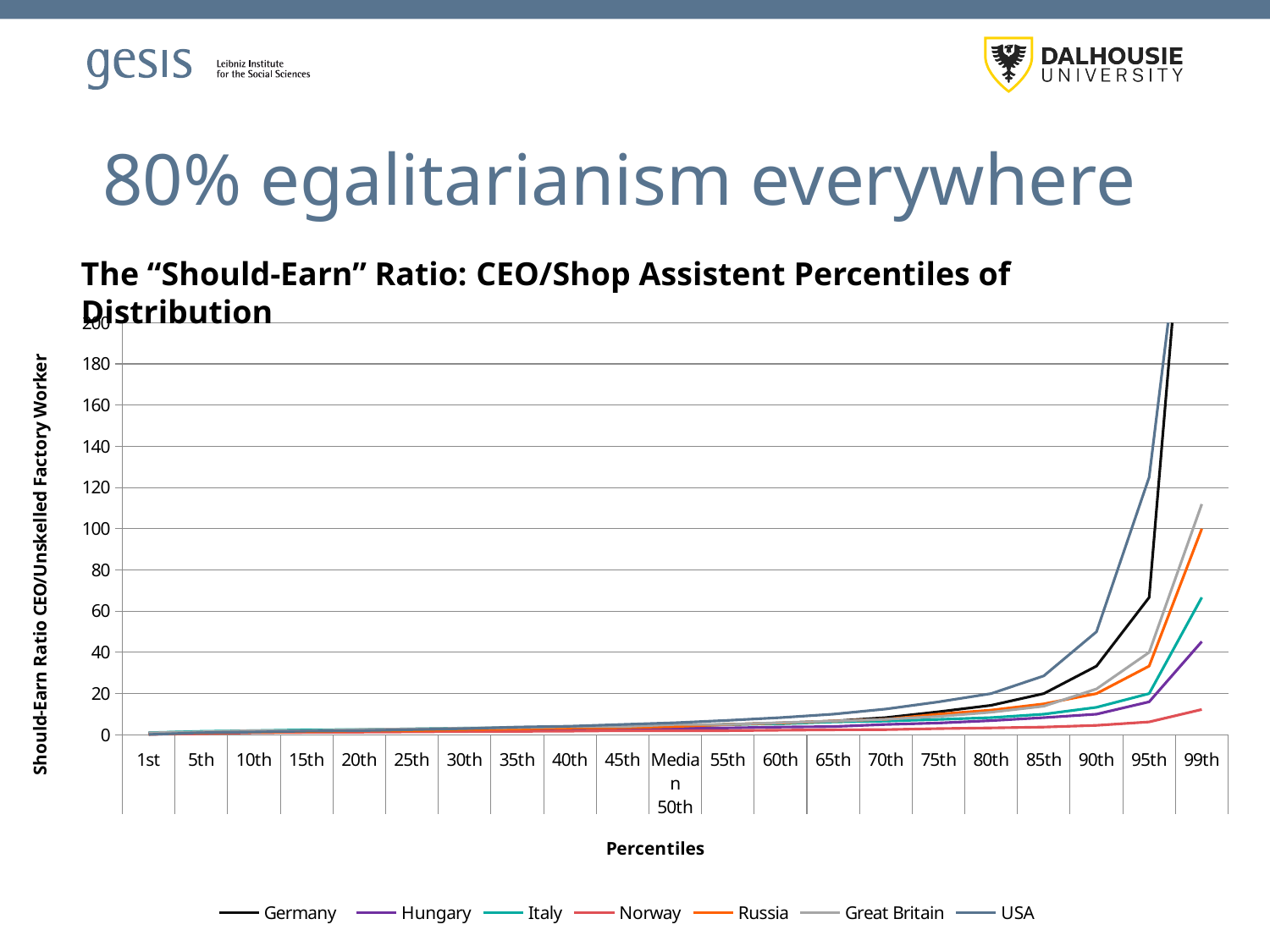
Which country has the lowest should-earn ratio at the 99th percentile? Norway Do the should-earn ratios rise or fall as the percentiles increase along the x axis? rise At the 99th percentile, which is larger: the value for Germany or the value for Hungary? Germany Is the value for Great Britain at the 99th percentile greater or less than 100? greater What kind of chart is shown on the slide? line chart Is the value for Hungary at the 99th percentile greater or less than 60? less Is the value for Norway at the 99th percentile greater or less than 20? less How many series does the legend list? 7 How many percentile categories are shown on the x axis? 21 What is the title of the x axis? Percentiles